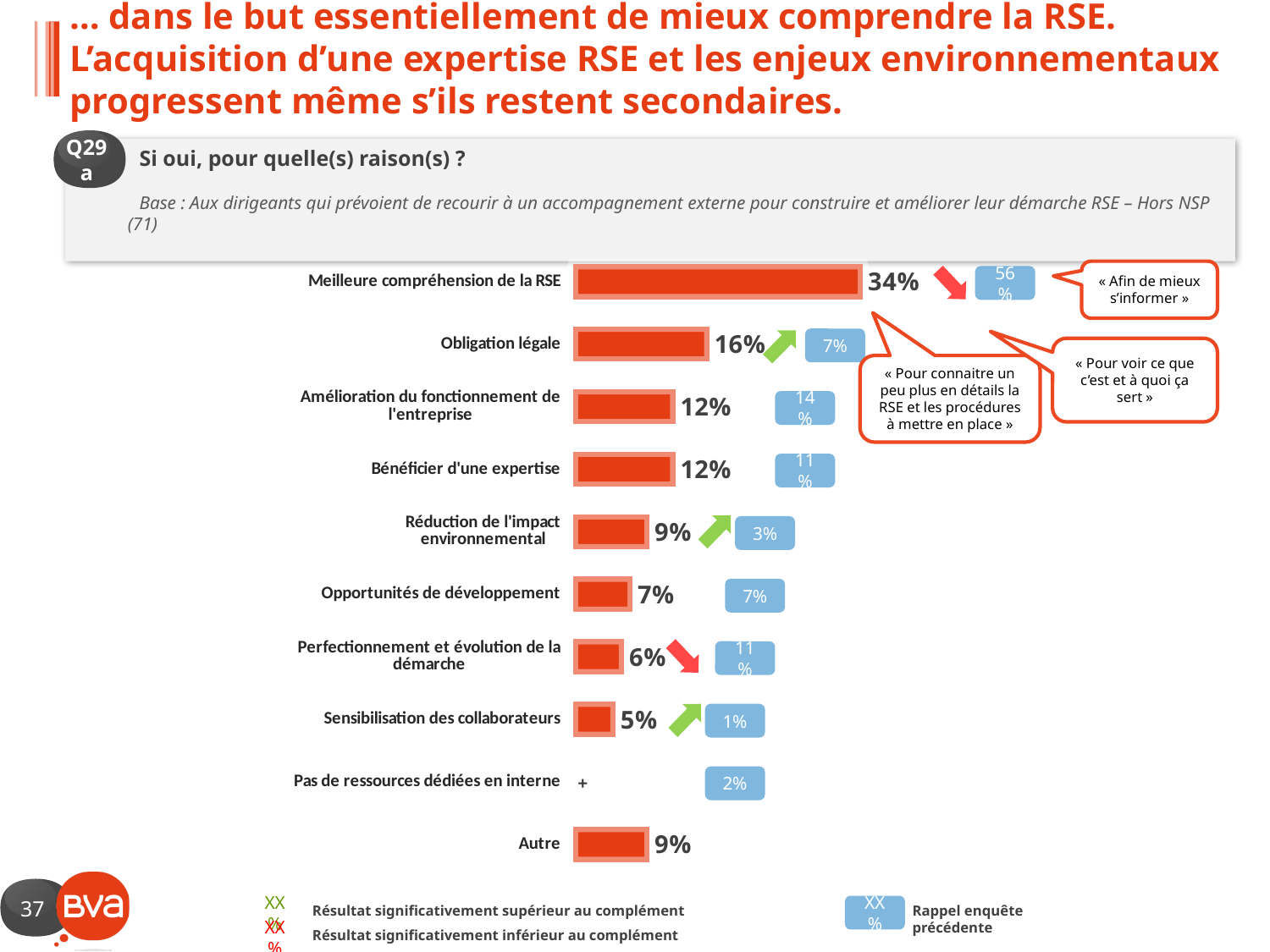
What kind of chart is shown on the slide? Bar chart What was the previous survey value (blue box) for "Meilleure compréhension de la RSE"? 56% What is the value for "Sensibilisation des collaborateurs"? 5% Which category has the highest value? Meilleure compréhension de la RSE Which is larger, the value for "Réduction de l'impact environnemental" or the value for "Perfectionnement et évolution de la démarche"? Réduction de l'impact environnemental What is the difference between the values for "Meilleure compréhension de la RSE" and "Obligation légale"? 18% What is the value for "Meilleure compréhension de la RSE"? 34% What is the value for "Obligation légale"? 16% What is the value for "Autre"? 9% What was the previous survey value (blue box) for "Réduction de l'impact environnemental"? 3% How many categories are shown in the bar chart? 10 What is the difference between the values for "Opportunités de développement" and "Sensibilisation des collaborateurs"? 2%